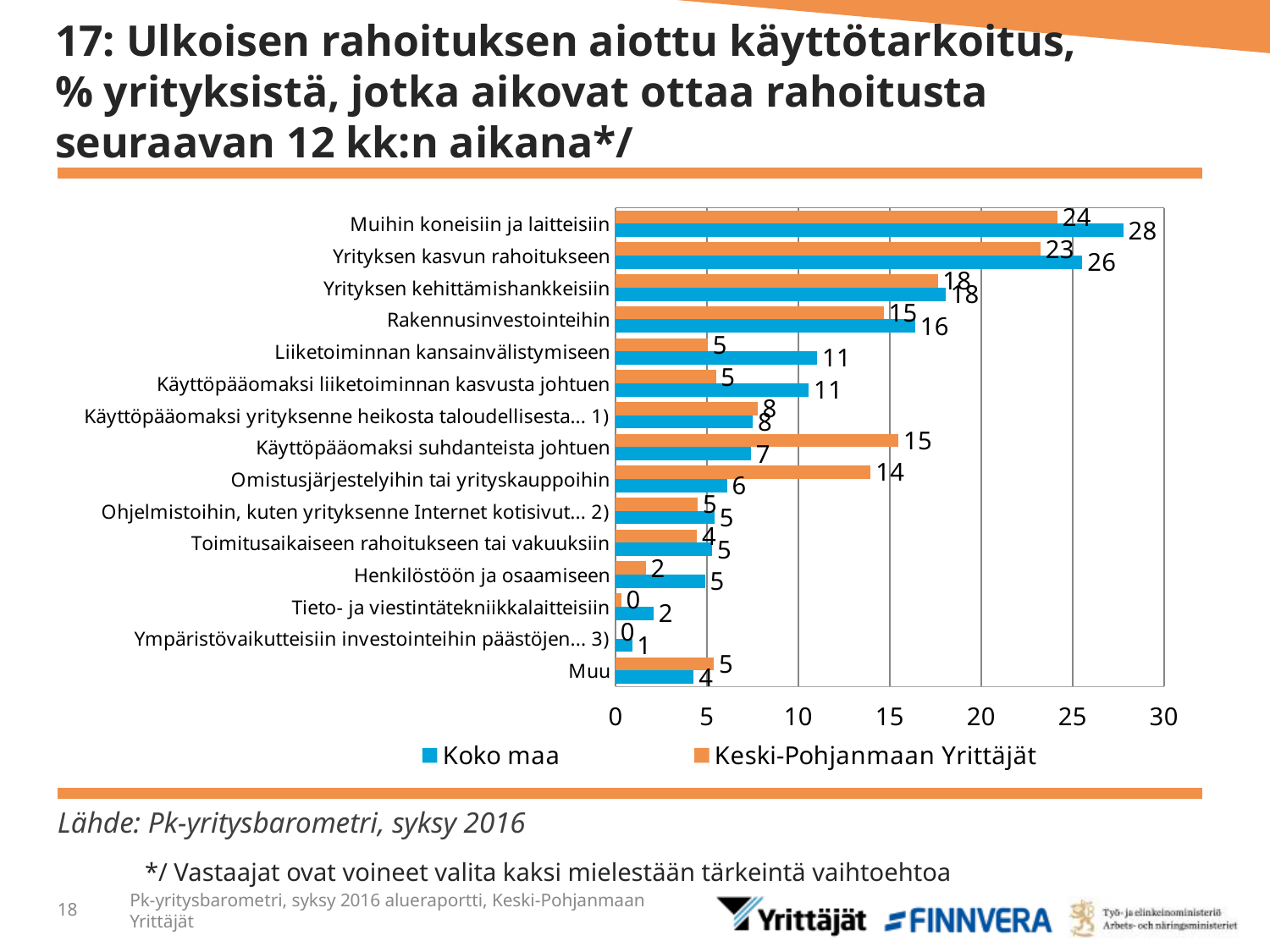
What is the Keski-Pohjanmaan Yrittäjät value for Käyttöpääomaksi suhdanteista johtuen? 15 What is the Koko maa value for Muihin koneisiin ja laitteisiin? 28 For Käyttöpääomaksi suhdanteista johtuen, which series has the larger value: Koko maa or Keski-Pohjanmaan Yrittäjät? Keski-Pohjanmaan Yrittäjät Is the Koko maa value for Yrityksen kasvun rahoitukseen greater or less than 25? greater Which category has the highest Koko maa value? Muihin koneisiin ja laitteisiin How many categories are shown on the chart? 15 Which colour represents Keski-Pohjanmaan Yrittäjät in the chart? Orange What is the difference between the Koko maa and Keski-Pohjanmaan Yrittäjät values for Liiketoiminnan kansainvälistymiseen? 6 What is the Keski-Pohjanmaan Yrittäjät value for Omistusjärjestelyihin tai yrityskauppoihin? 14 What kind of chart is shown on the slide? Bar chart How many series does the legend list? 2 Which category has the lowest Koko maa value? Ympäristövaikutteisiin investointeihin päästöjen... 3)